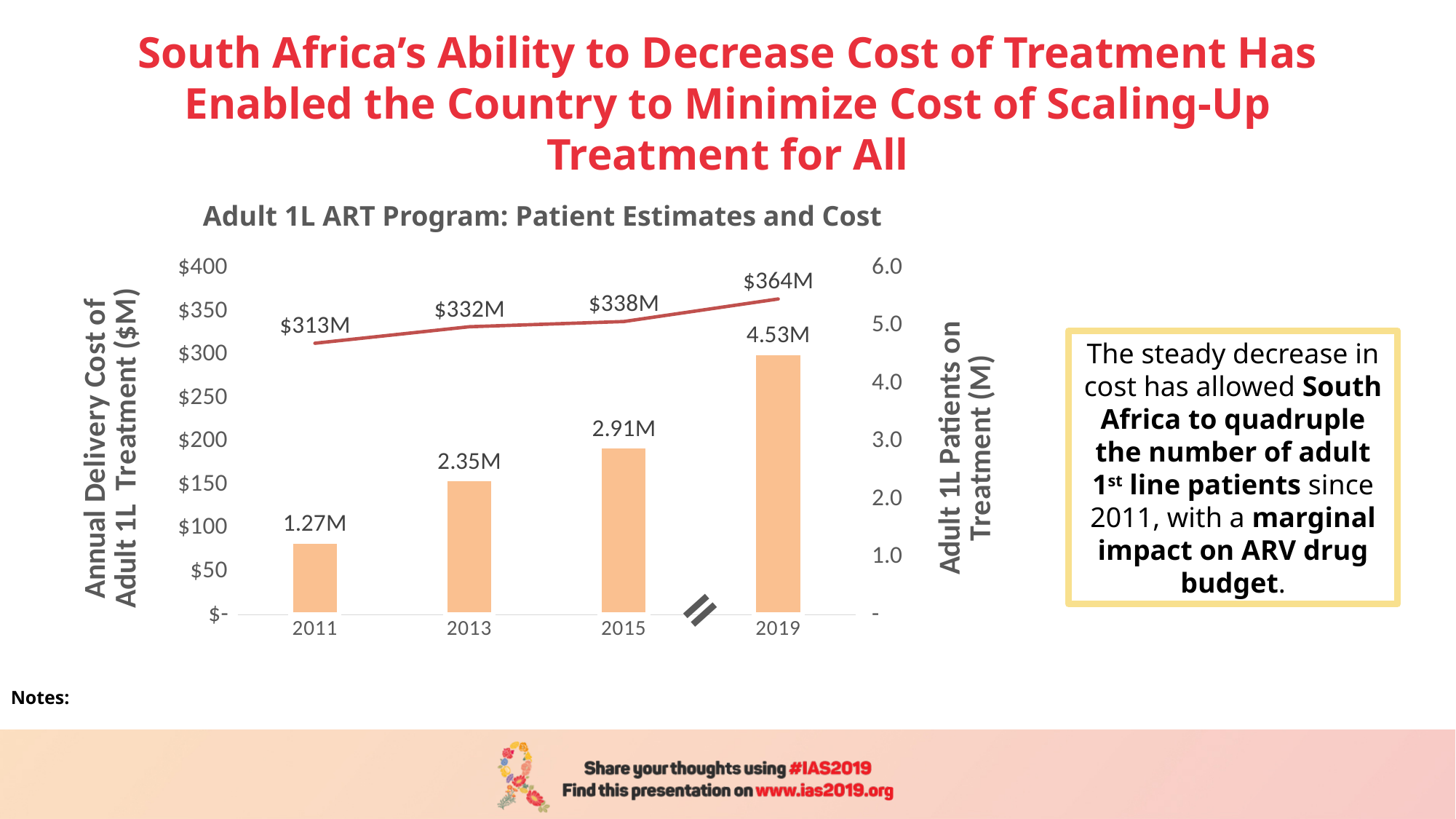
What is the annual delivery cost shown for 2015? $338M Which year has more adult 1L patients on treatment, 2013 or 2015? 2015 Which year has the lowest annual delivery cost? 2011 How many years are shown on the x axis of the chart? 4 What is the annual delivery cost shown for 2011? $313M What is the difference in adult 1L patients between 2015 and 2013? 0.56M How many adult 1L patients on treatment are shown for 2019? 4.53M What is the title of the chart? Adult 1L ART Program: Patient Estimates and Cost Which year has the highest number of adult 1L patients on treatment? 2019 What is the difference in annual delivery cost between 2019 and 2011? $51M What is the label of the right-hand vertical axis? Adult 1L Patients on Treatment (M) Do the annual delivery cost values rise or fall from 2011 to 2019? rise